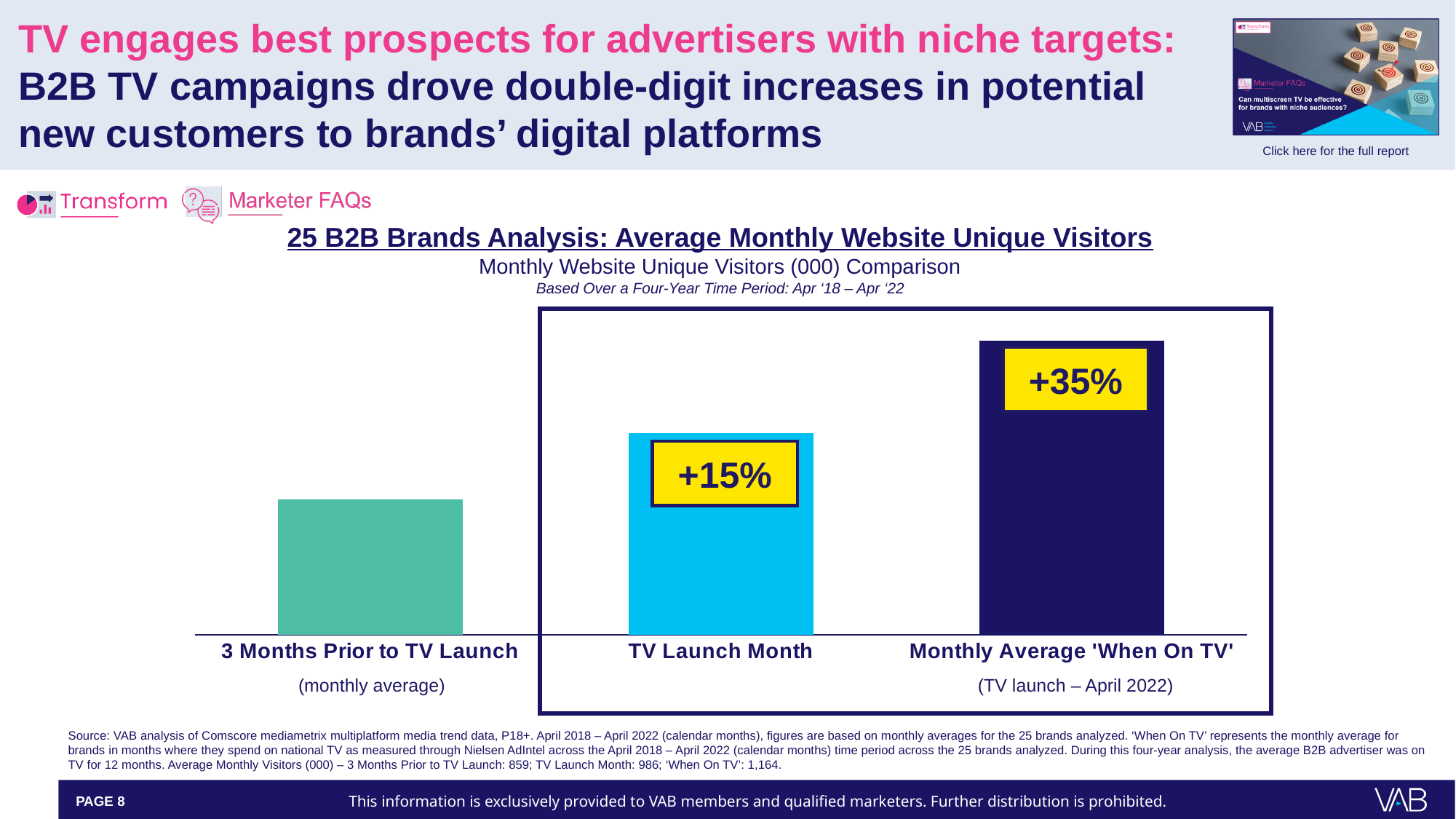
Which category has the shortest bar? 3 Months Prior to TV Launch Do the bar values rise or fall from left to right across the chart? Rise Which category has the tallest bar? Monthly Average 'When On TV' What time period does the chart subtitle say the analysis is based over? Apr '18 – Apr '22 Which bar is taller: TV Launch Month or 3 Months Prior to TV Launch? TV Launch Month How many bars are plotted in the chart? 3 According to the source note, what is the average monthly visitors (000) figure for TV Launch Month? 986 According to the source note, what is the average monthly visitors (000) figure for 'When On TV'? 1,164 What kind of chart is shown on the slide? Bar chart What percentage increase is shown on the bar for Monthly Average 'When On TV'? +35% What percentage increase is shown on the bar for TV Launch Month? +15% Using the figures in the source note, what is the difference in average monthly visitors (000) between 'When On TV' and TV Launch Month? 178